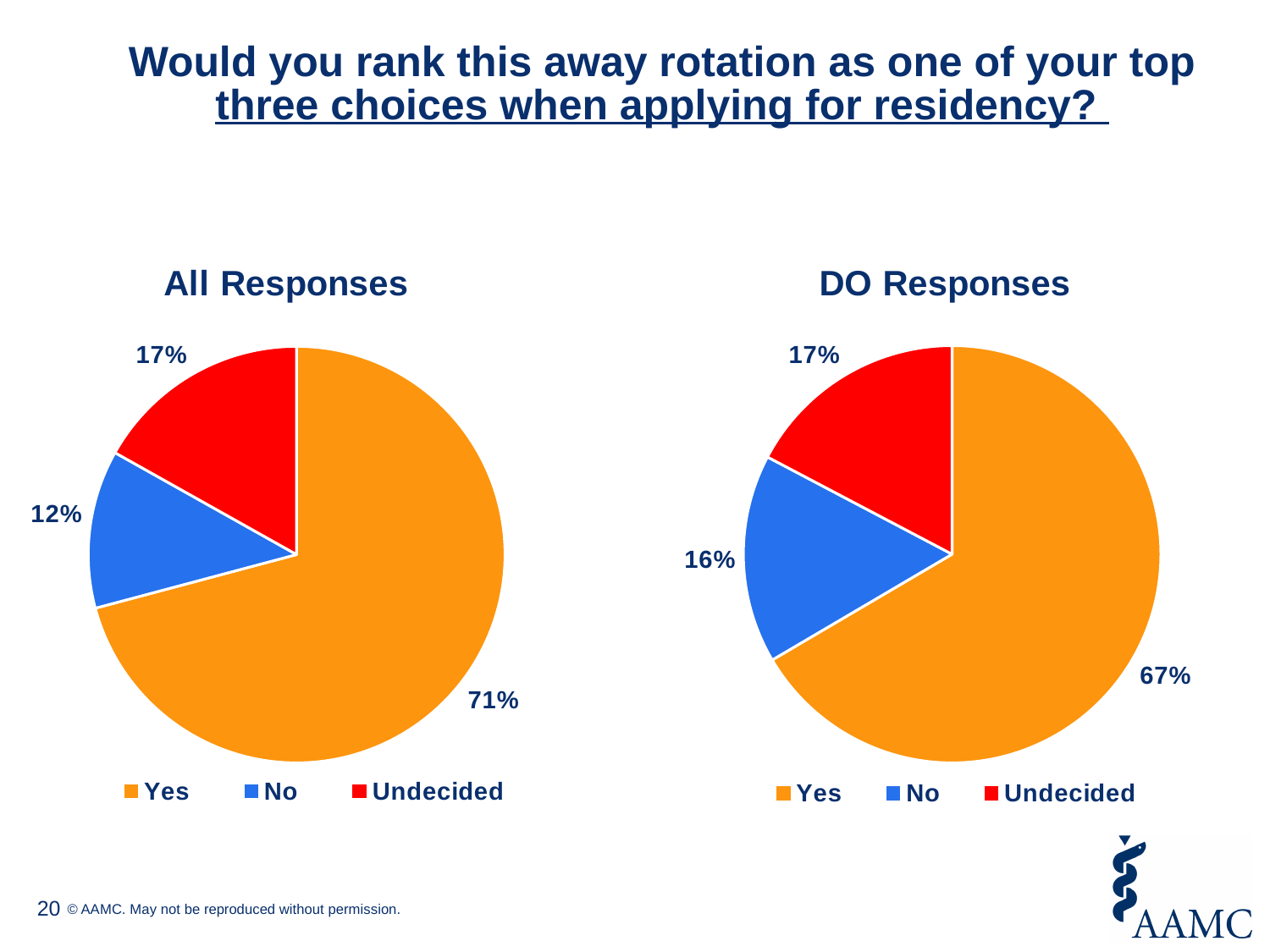
In the "All Responses" chart, which response has the smallest share? No In the "All Responses" chart, what is the difference between the Undecided share and the No share? 5 percentage points What is the difference between the Yes share in the "All Responses" chart and the Yes share in the "DO Responses" chart? 4 percentage points In the "DO Responses" chart, what percentage of respondents were Undecided? 17% In the "All Responses" chart, what percentage of respondents answered Yes? 71% What type of chart is used on this slide? Pie chart In the "DO Responses" chart, what percentage of respondents answered No? 16% In the "DO Responses" chart, which response has the largest share? Yes In the "All Responses" chart, what colour represents the Undecided slice? Red How many slices does the "DO Responses" pie chart have? 3 In the "All Responses" chart, which response has the largest share? Yes Is the No share larger in the "All Responses" chart or the "DO Responses" chart? DO Responses